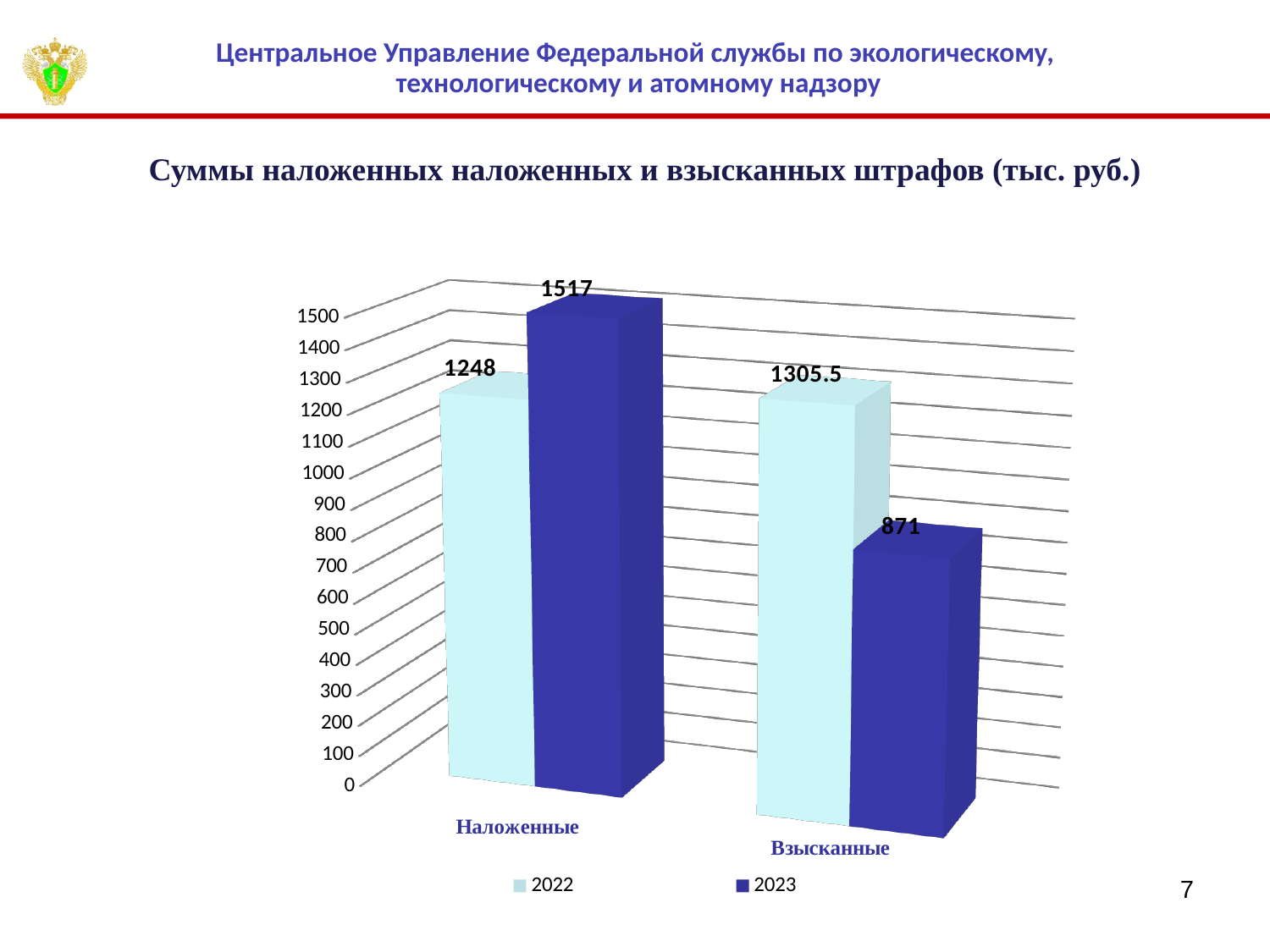
What is the value for Наложенные in 2023? 1517 How many series does the legend list? 2 Which is larger for Взысканные: the 2022 value or the 2023 value? 2022 What is the value for Взысканные in 2022? 1305.5 How many categories are shown on the x axis? 2 Which category has the highest value in the 2023 series? Наложенные What is the value for Взысканные in 2023? 871 Which category has the lowest value in the 2023 series? Взысканные What is the difference between the 2023 and 2022 values for Наложенные? 269 What is the difference between the 2022 and 2023 values for Взысканные? 434.5 What is the value for Наложенные in 2022? 1248 What kind of chart is shown on the slide? Bar chart